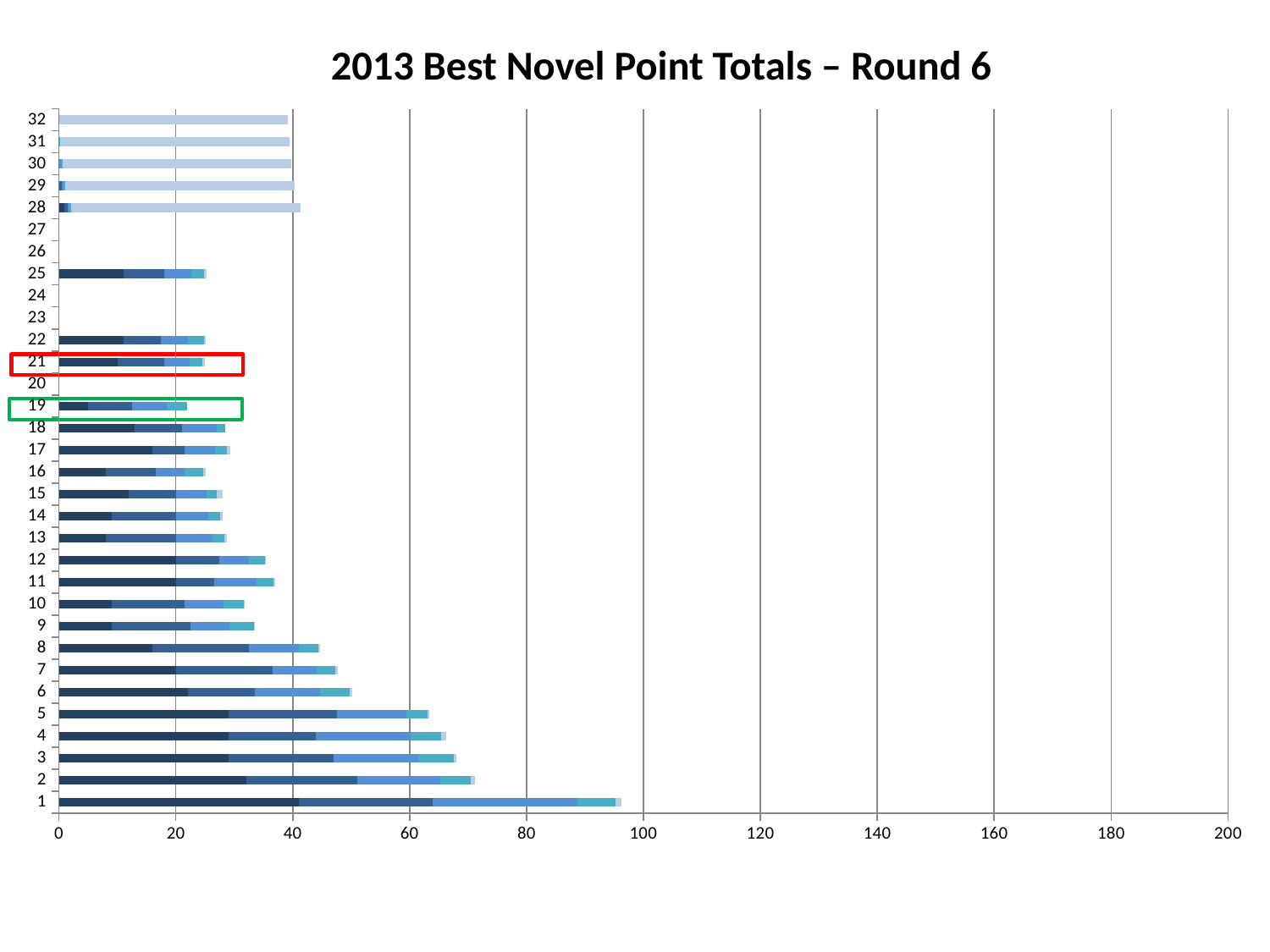
Which has the larger total, category 8 or category 12? Category 8 Is the total value for category 2 greater or less than 60? greater What kind of chart is shown on the slide? Stacked bar chart Is the total value for category 1 greater or less than 100? less Is the total value for category 12 greater or less than 40? less Which category label is outlined with a red box on the chart? 21 Which has the larger total, category 5 or category 6? Category 5 Which category has the longest bar in the chart? 1 How many categories are listed on the vertical axis of the chart? 32 What is the title of the chart? 2013 Best Novel Point Totals – Round 6